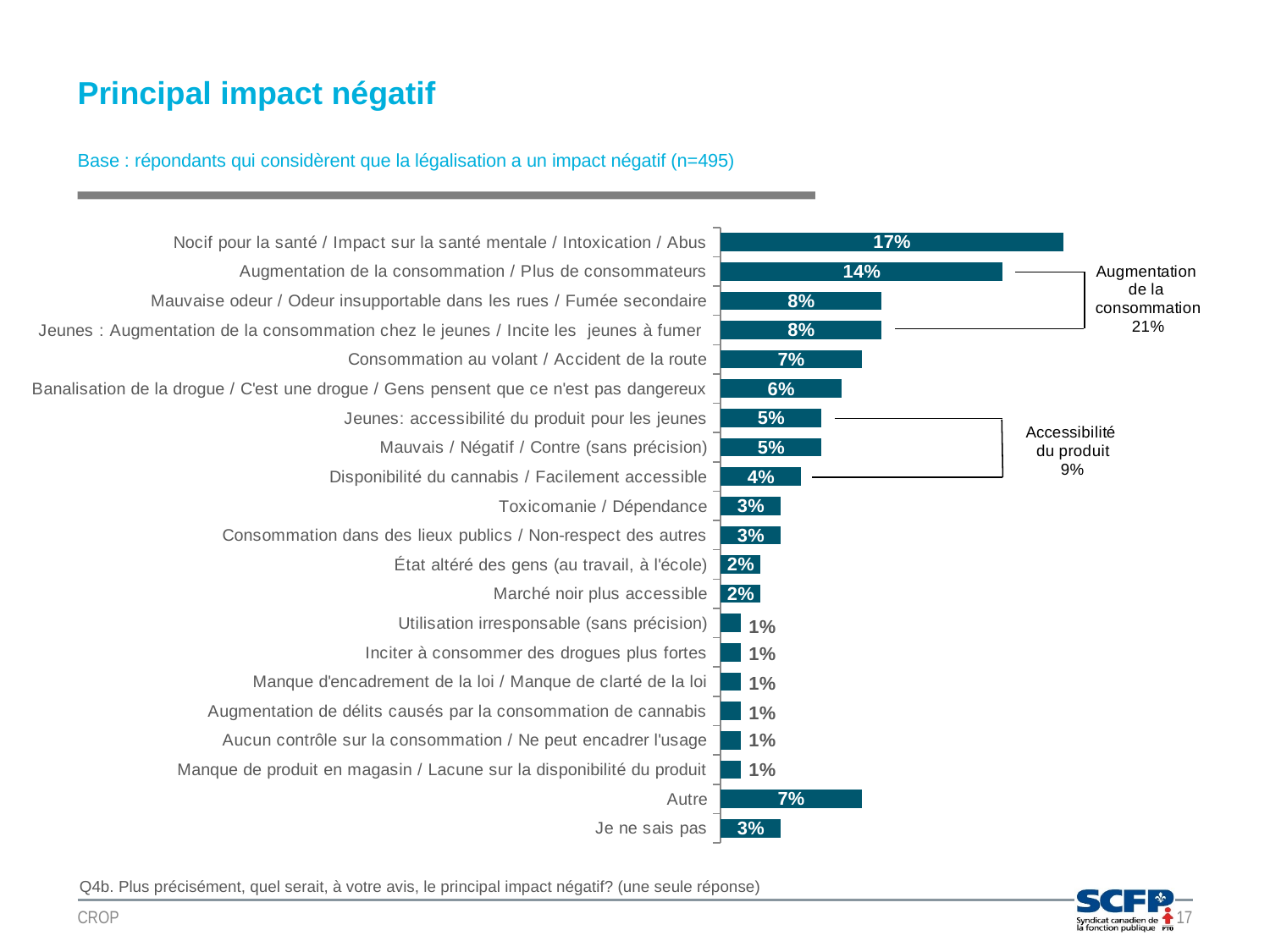
What is the value for "Augmentation de la consommation / Plus de consommateurs"? 14% What combined value is shown for the "Accessibilité du produit" grouping annotation? 9% Which is larger: "Banalisation de la drogue / C'est une drogue / Gens pensent que ce n'est pas dangereux" or "Disponibilité du cannabis / Facilement accessible"? Banalisation de la drogue / C'est une drogue / Gens pensent que ce n'est pas dangereux What is the value for "Consommation au volant / Accident de la route"? 7% What is the difference between "Nocif pour la santé / Impact sur la santé mentale / Intoxication / Abus" and "Augmentation de la consommation / Plus de consommateurs"? 3% What is the value for "Marché noir plus accessible"? 2% What kind of chart is shown on the slide? Bar chart Which category has the highest value? Nocif pour la santé / Impact sur la santé mentale / Intoxication / Abus What is the value for "Nocif pour la santé / Impact sur la santé mentale / Intoxication / Abus"? 17% How many categories are shown in the chart? 21 What combined value is shown for the "Augmentation de la consommation" grouping annotation? 21% What is the value for "Je ne sais pas"? 3%